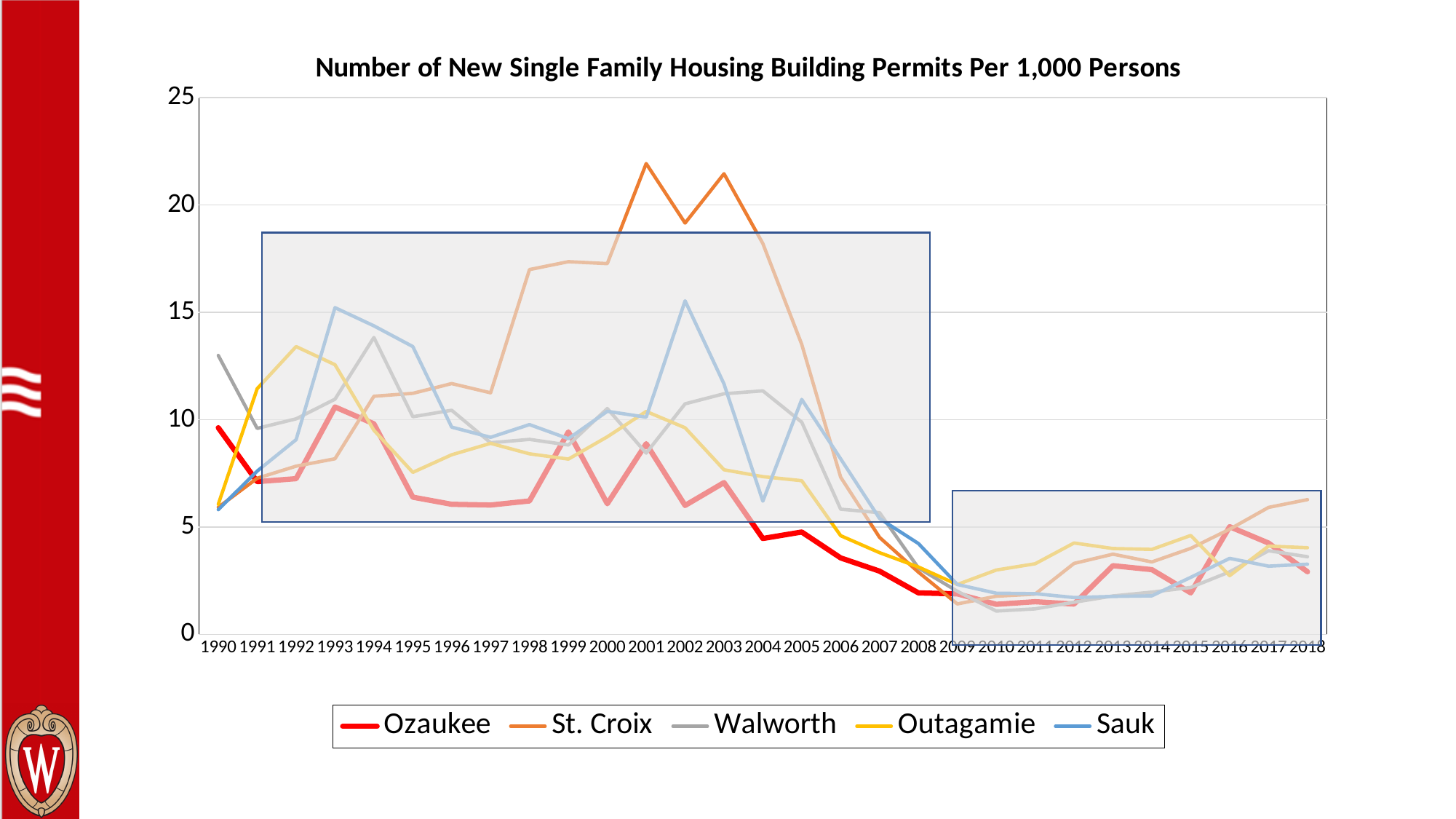
Which county has the highest value in 2001? St. Croix Is the value for St. Croix in 2001 greater or less than 20? greater Does the Ozaukee line rise or fall from 2004 to 2008? fall How many years are plotted along the x axis? 29 What is the title of the chart? Number of New Single Family Housing Building Permits Per 1,000 Persons How many series does the legend list? 5 Which county has the highest value in 1990? Walworth Is the value for Walworth in 1990 greater or less than 10? greater What kind of chart is shown on the slide? line chart Which is larger in 2003, the value for St. Croix or the value for Ozaukee? St. Croix Is the value for Ozaukee in 2008 greater or less than 5? less Which county has the lowest value in 2004? Ozaukee